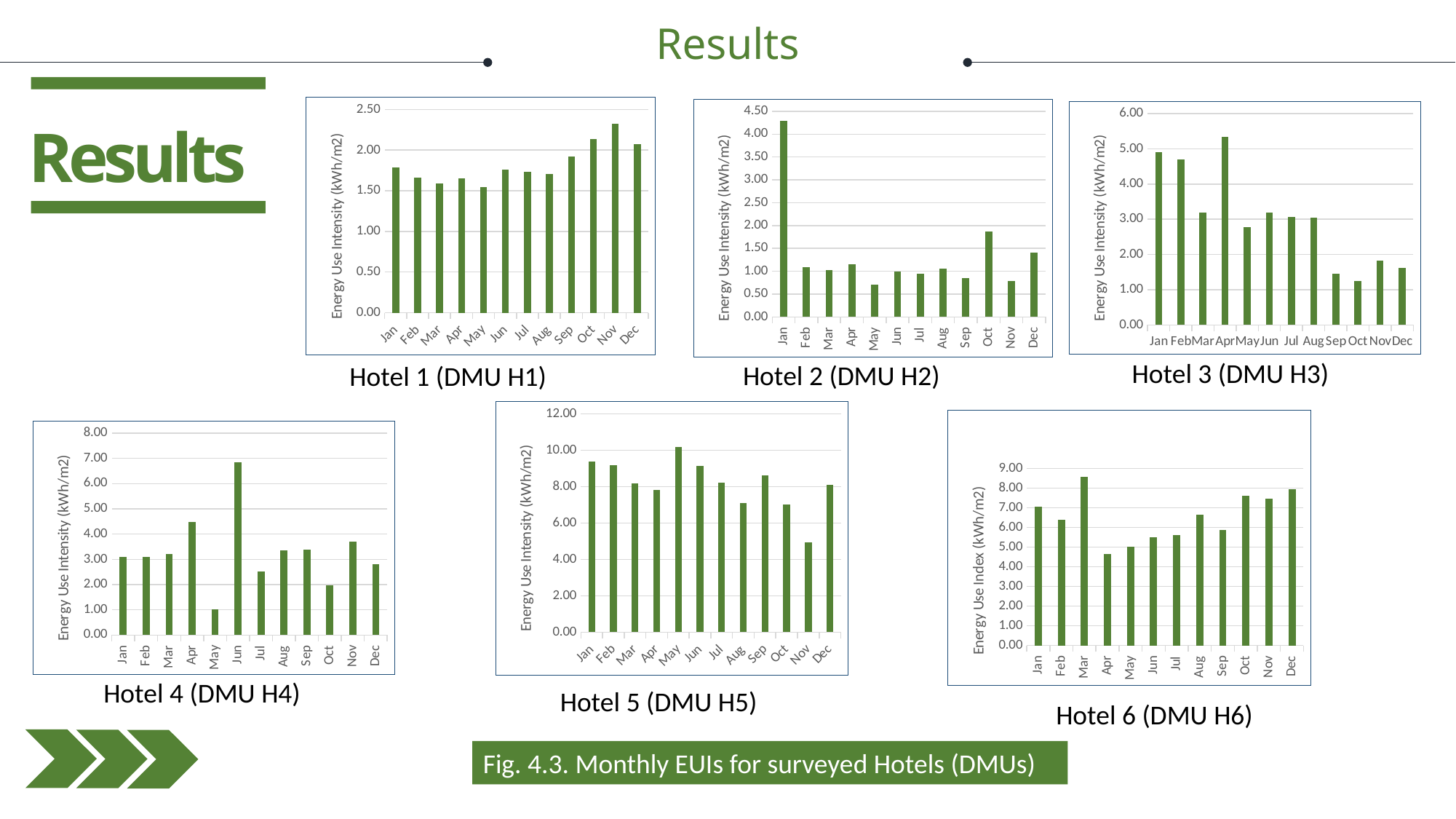
In the Hotel 1 (DMU H1) chart, which month has the highest energy use intensity? Nov In the Hotel 1 (DMU H1) chart, is the value for Nov greater or less than 2.00? greater In the Hotel 4 (DMU H4) chart, which month has the lowest energy use intensity? May In the Hotel 2 (DMU H2) chart, which is larger, the value for Oct or the value for Dec? Oct What kind of chart is used for Hotel 3 (DMU H3)? Bar chart In the Hotel 4 (DMU H4) chart, is the value for Jun greater or less than 6.00? greater In the Hotel 2 (DMU H2) chart, is the value for Jan greater or less than 4.00? greater In the Hotel 3 (DMU H3) chart, which month has the highest energy use intensity? Apr In the Hotel 6 (DMU H6) chart, which month has the highest energy use index? Mar In the Hotel 5 (DMU H5) chart, which month has the lowest energy use intensity? Nov How many months are plotted on the x axis of the Hotel 5 (DMU H5) chart? 12